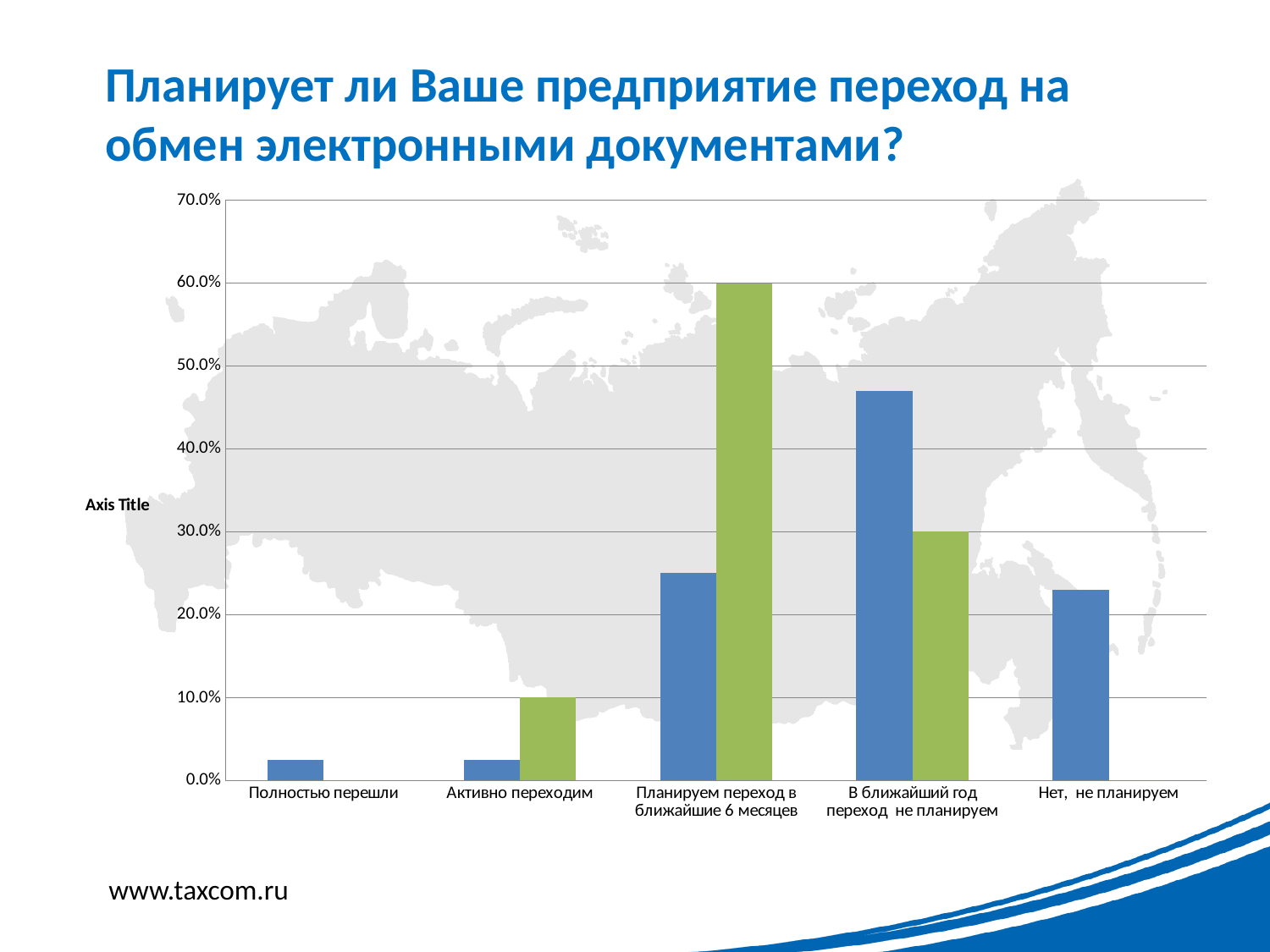
What is the value of the green bar for 'Активно переходим'? 10.0% Which category has the tallest blue bar? В ближайший год переход не планируем For 'Планируем переход в ближайшие 6 месяцев', which bar is taller, the blue or the green? green How many categories are shown on the x axis of the chart? 5 Is the blue bar for 'В ближайший год переход не планируем' greater or less than 40.0%? greater What is the difference between the green bars for 'Планируем переход в ближайшие 6 месяцев' and 'В ближайший год переход не планируем'? 30.0% Which category has the tallest green bar? Планируем переход в ближайшие 6 месяцев Is the blue bar for 'Нет, не планируем' greater or less than 30.0%? less What is the value of the green bar for 'В ближайший год переход не планируем'? 30.0% Is the blue bar for 'Полностью перешли' greater or less than 10.0%? less What kind of chart is shown on the slide? bar chart What is the value of the green bar for 'Планируем переход в ближайшие 6 месяцев'? 60.0%